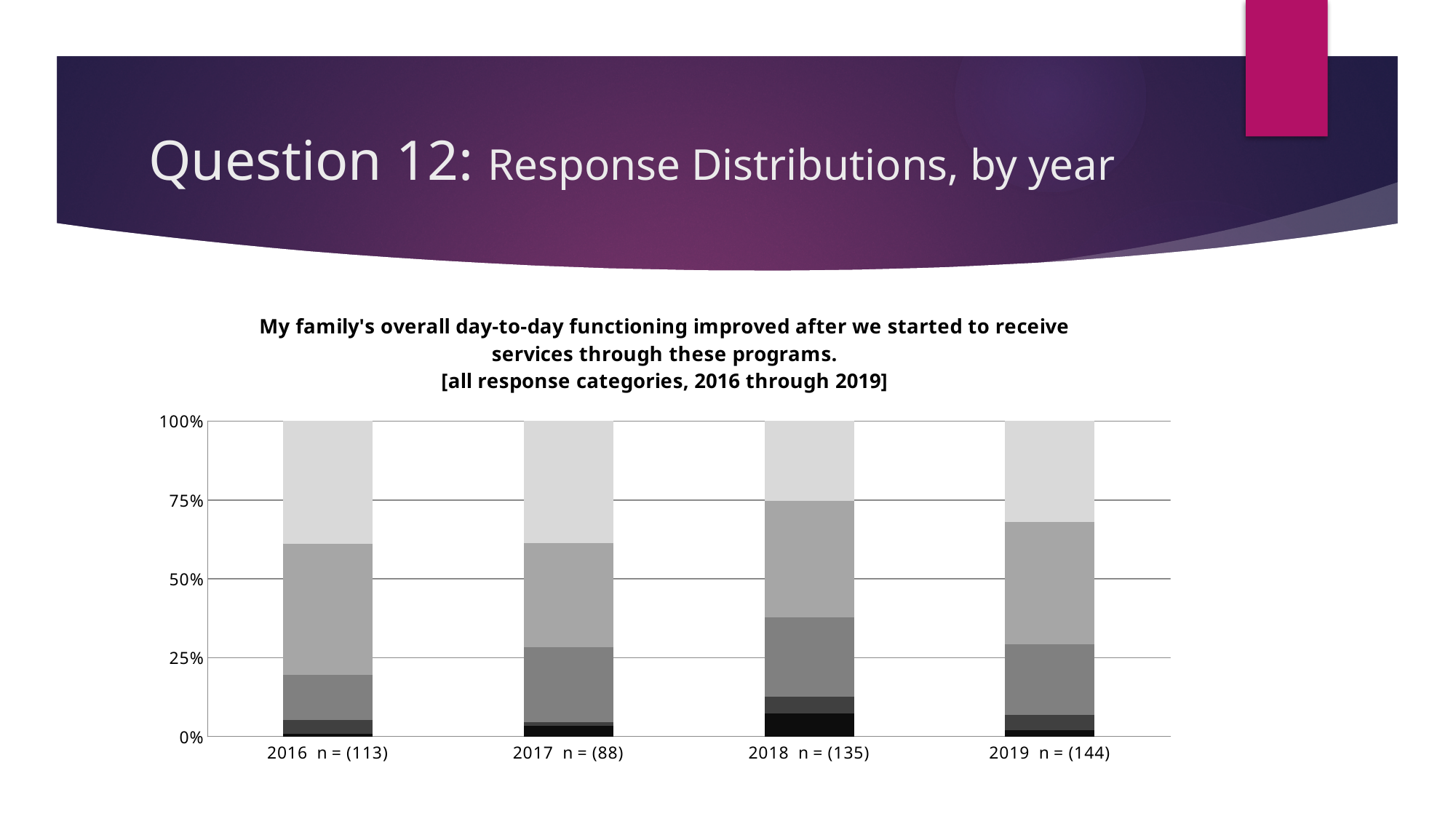
What is the sample size (n) shown for 2017? 88 What kind of chart is shown on the slide? Stacked bar chart What is the sample size (n) shown for 2018? 135 Which year has the smallest sample size (n)? 2017 Is the lightest (top) segment of the 2016 bar greater or less than 25% of the bar? greater What range does the y axis of the chart cover? 0% to 100% What survey statement is given in the chart title? My family's overall day-to-day functioning improved after we started to receive services through these programs. Which year has the larger sample size, 2016 or 2018? 2018 Which year has the largest sample size (n)? 2019 Which year's bar has the smallest lightest (top) segment? 2018 How many years (bars) are shown on the x axis of the chart? 4 How much larger is the sample size for 2019 than for 2016? 31